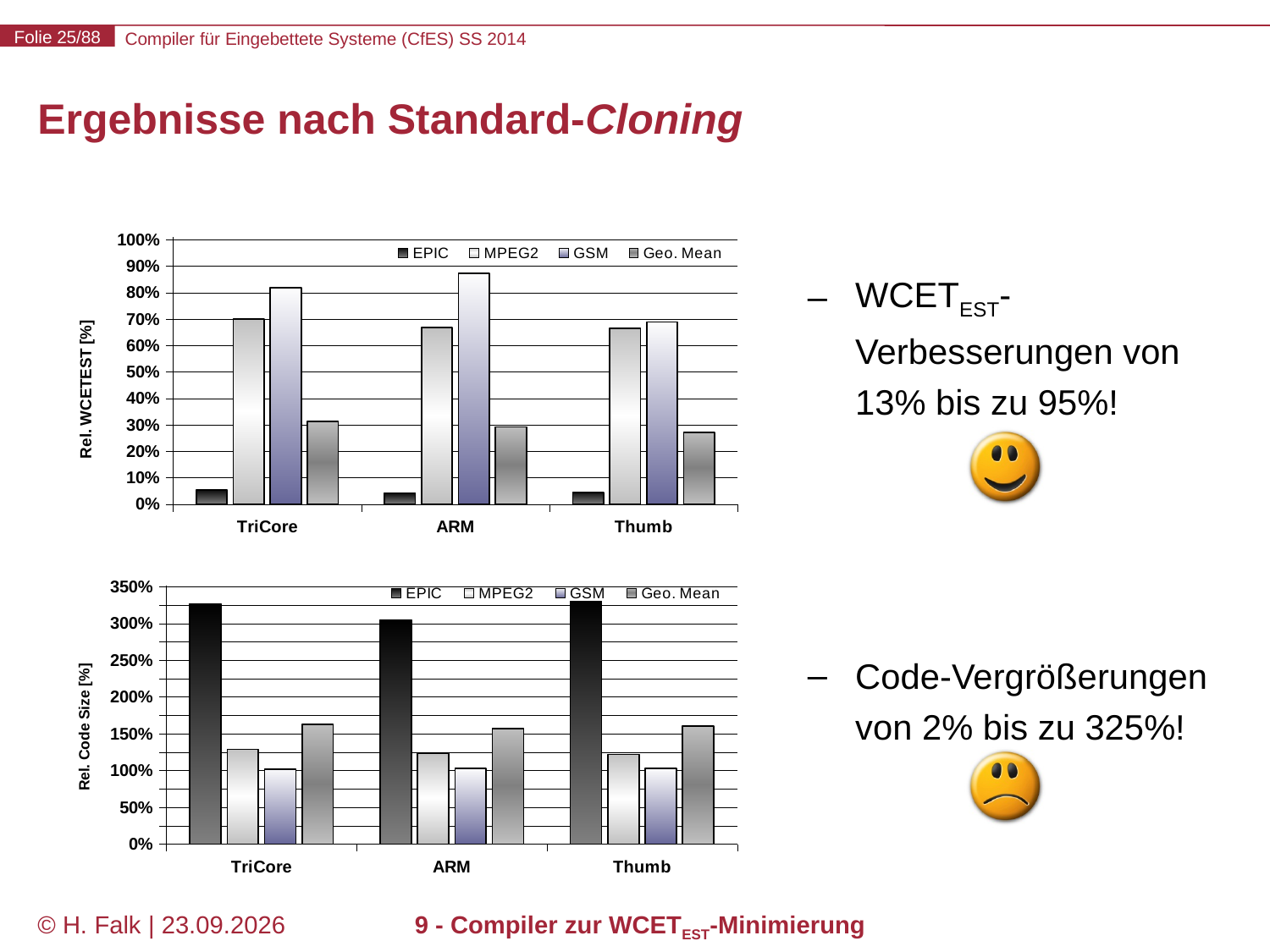
In the top chart (Rel. WCETEST [%]), is the GSM value for ARM greater or less than 80%? greater How many categories are shown on the x axis of the top chart (Rel. WCETEST [%])? 3 In the top chart (Rel. WCETEST [%]), which series has the highest value for ARM? GSM What is the y-axis label of the bottom chart? Rel. Code Size [%] How many series does the legend of the bottom chart (Rel. Code Size [%]) list? 4 What kind of chart is the top chart (Rel. WCETEST [%])? bar chart In the bottom chart (Rel. Code Size [%]), is the Geo. Mean value for Thumb greater or less than 150%? greater In the top chart (Rel. WCETEST [%]), is the EPIC value for TriCore greater or less than 10%? less In the top chart (Rel. WCETEST [%]), which series has the lowest value for Thumb? EPIC In the bottom chart (Rel. Code Size [%]), which is larger for ARM: the MPEG2 value or the GSM value? MPEG2 In the bottom chart (Rel. Code Size [%]), which series has the highest value for TriCore? EPIC